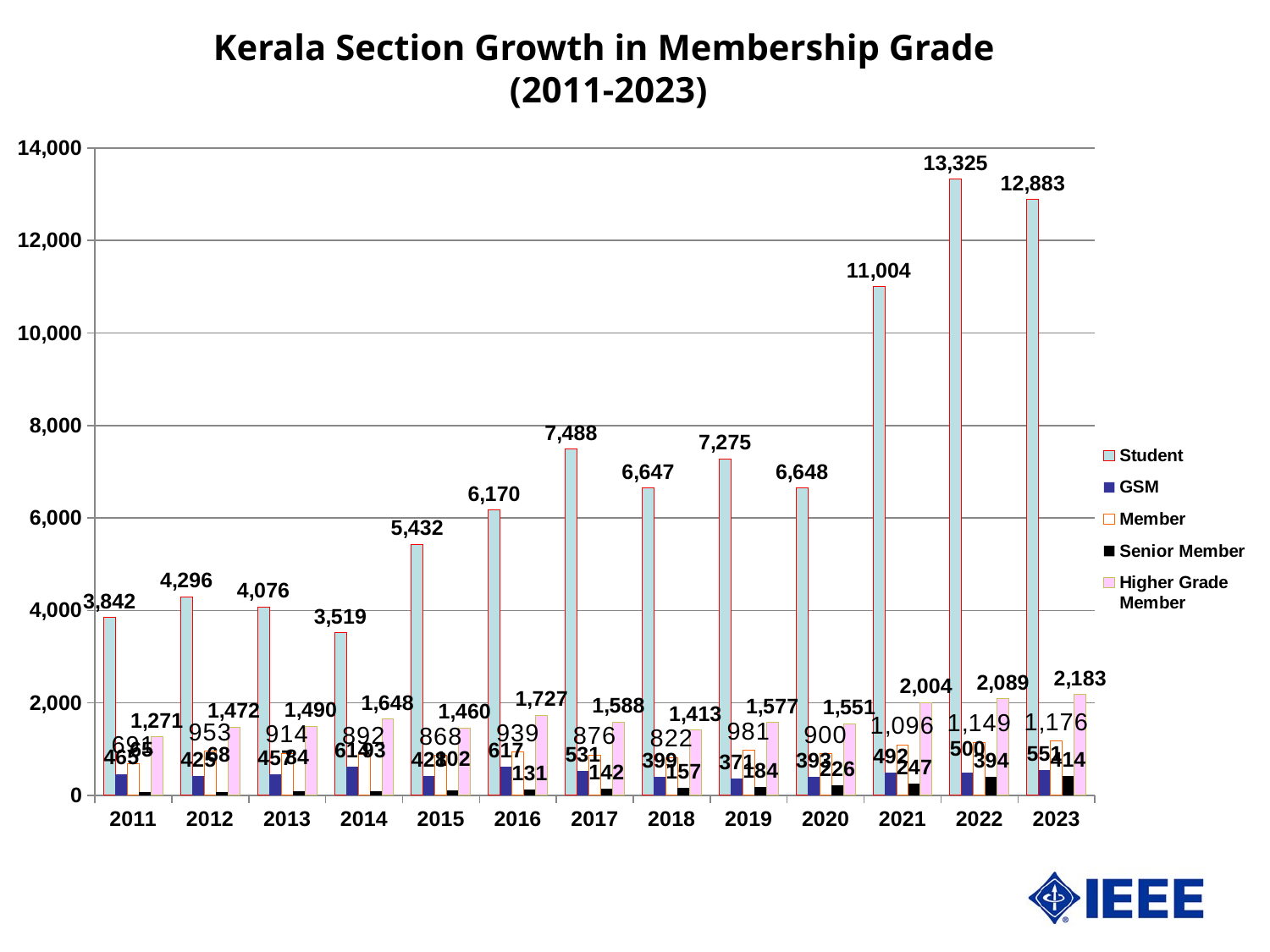
What is the difference between the Student values for 2022 and 2023? 442 How many series does the legend list? 5 What type of chart is shown on the slide? bar chart What is the Higher Grade Member value for 2023? 2,183 What is the Student value for 2022? 13,325 What is the Member value for 2021? 1,096 Which is larger, the Student value for 2017 or for 2019? 2017 Do the Senior Member values rise or fall from 2016 to 2023? rise In which year is the Student value highest? 2022 How many years are shown on the x axis? 13 What is the Senior Member value for 2020? 226 In which year is the Student value lowest? 2014